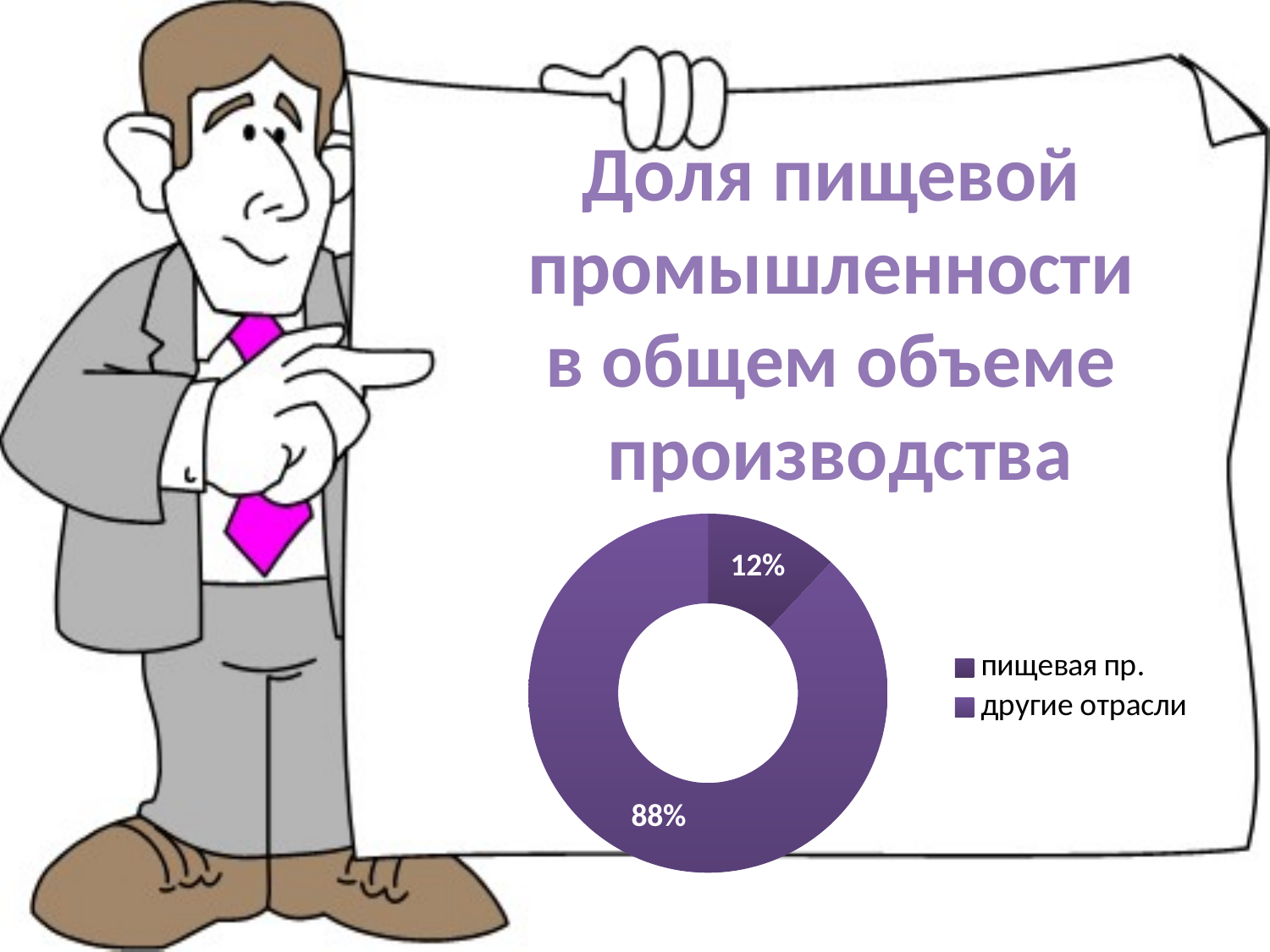
How many categories are shown in the chart? 2 What is the difference in percentage points between "другие отрасли" and "пищевая пр."? 76 Which category has the smallest share in the chart? пищевая пр. What kind of chart is shown on the slide? Pie chart (doughnut) What is the total of the two shares shown in the chart? 100% What is the title of the chart on the slide? Доля пищевой промышленности в общем объеме производства Which category has the largest share in the chart? другие отрасли What share of the chart does "пищевая пр." represent? 12% How many entries does the legend list? 2 What share of the chart does "другие отрасли" represent? 88% Which is larger: the share for "пищевая пр." or the share for "другие отрасли"? другие отрасли